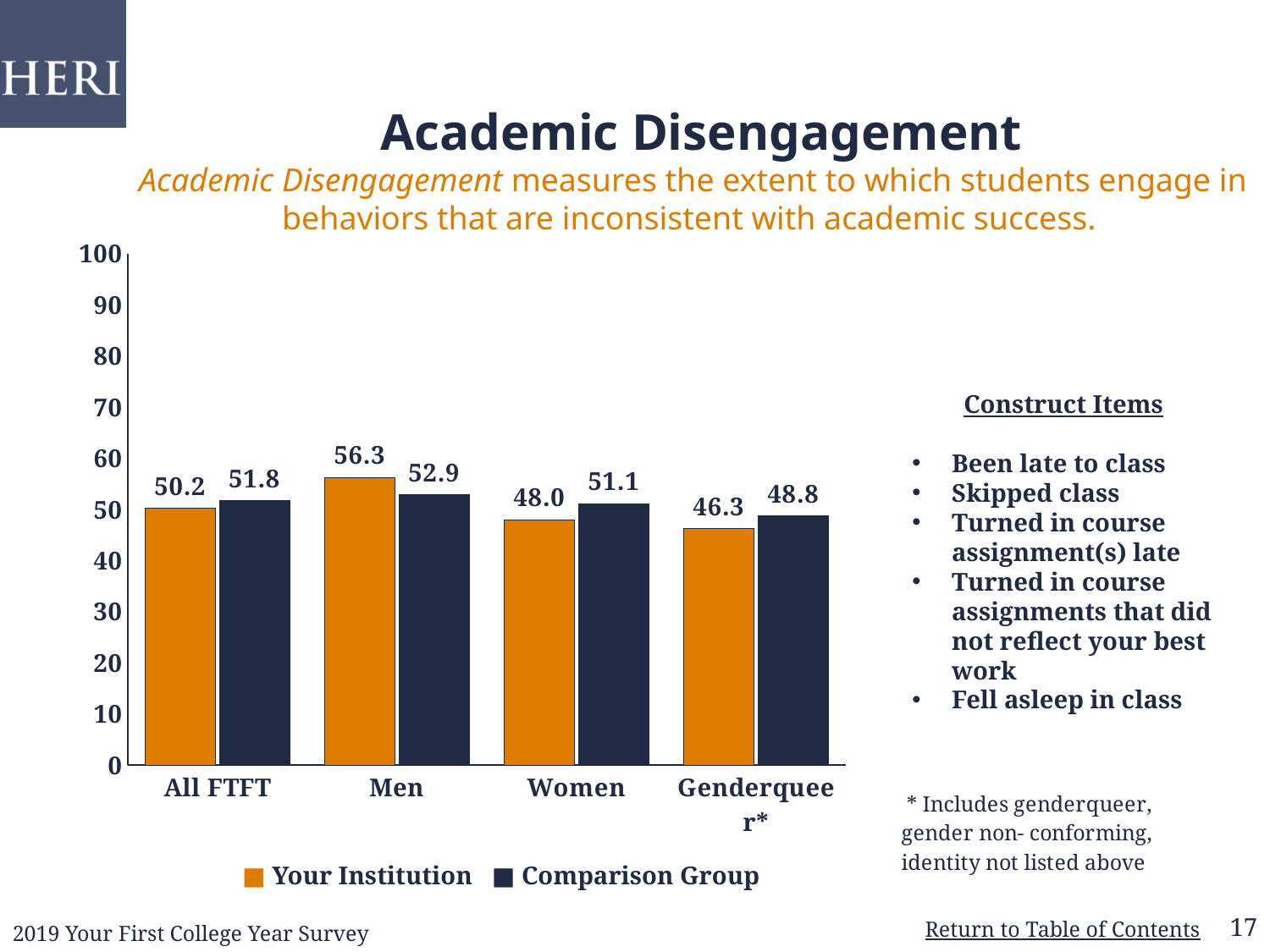
What is the difference between the Your Institution and Comparison Group values for Women? 3.1 What kind of chart is shown on the slide? bar chart What is the Comparison Group value for Women? 51.1 For Men, which is larger: Your Institution or Comparison Group? Your Institution How many categories are shown on the x axis? 4 Which category has the highest Your Institution value? Men What is the Your Institution value for Genderqueer? 46.3 What colour are the Your Institution bars? orange Which category has the lowest Comparison Group value? Genderqueer How many series does the legend list? 2 What is the Your Institution value for Men? 56.3 Is the Comparison Group value for All FTFT greater or less than 50? greater